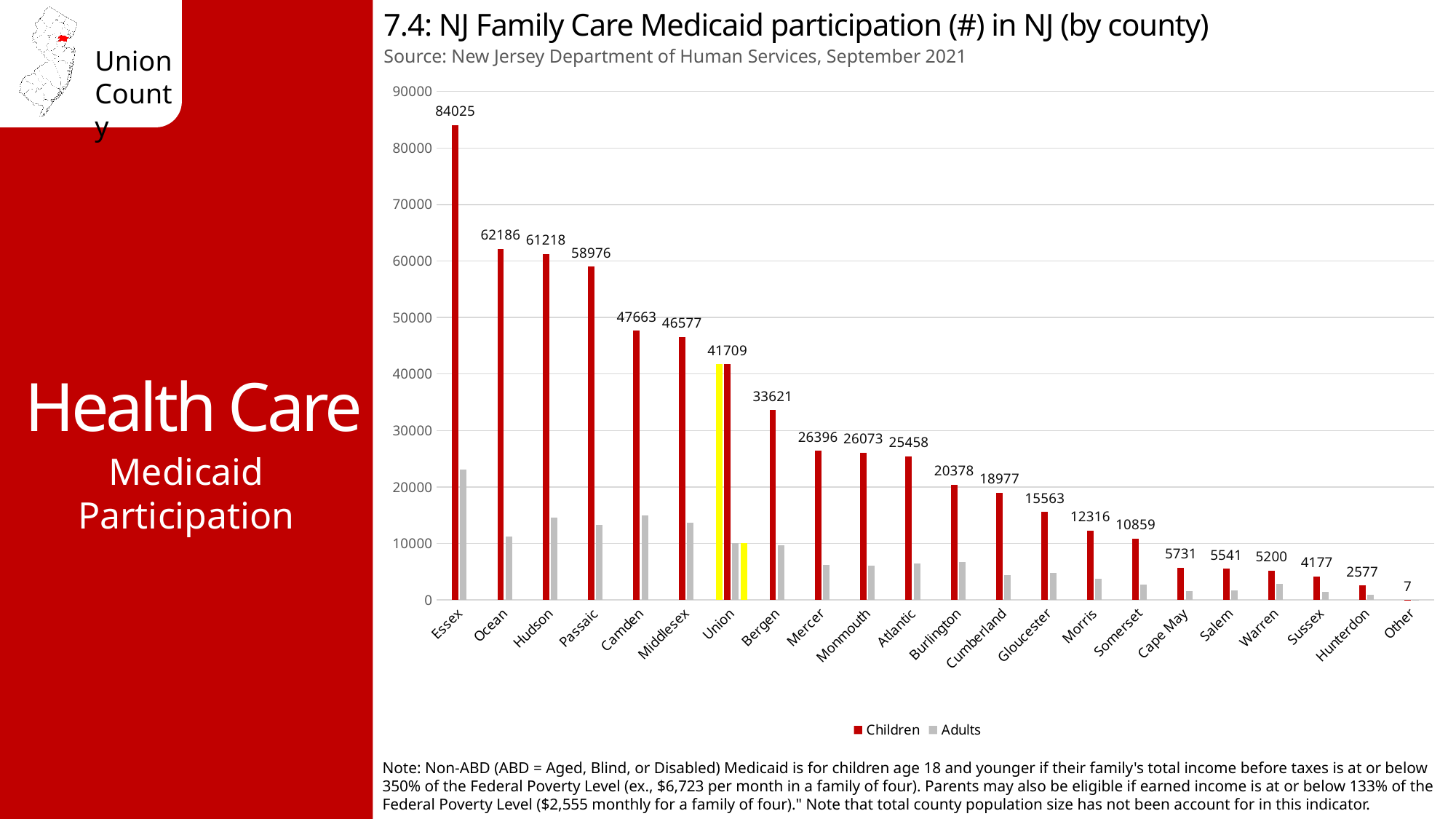
What is the Children value for Union? 41709 Which has the larger Children value, Camden or Middlesex? Camden How many series does the legend list? 2 What kind of chart is shown? bar chart Which county has the highest Children value? Essex How many categories are shown on the x axis? 22 What is the Children value for Essex? 84025 What is the Children value for Hunterdon? 2577 Which county's bars are highlighted in yellow? Union What is the difference between the Children values for Ocean and Hudson? 968 Which category has the lowest Children value? Other Is the Adults value for Essex greater or less than 20000? greater